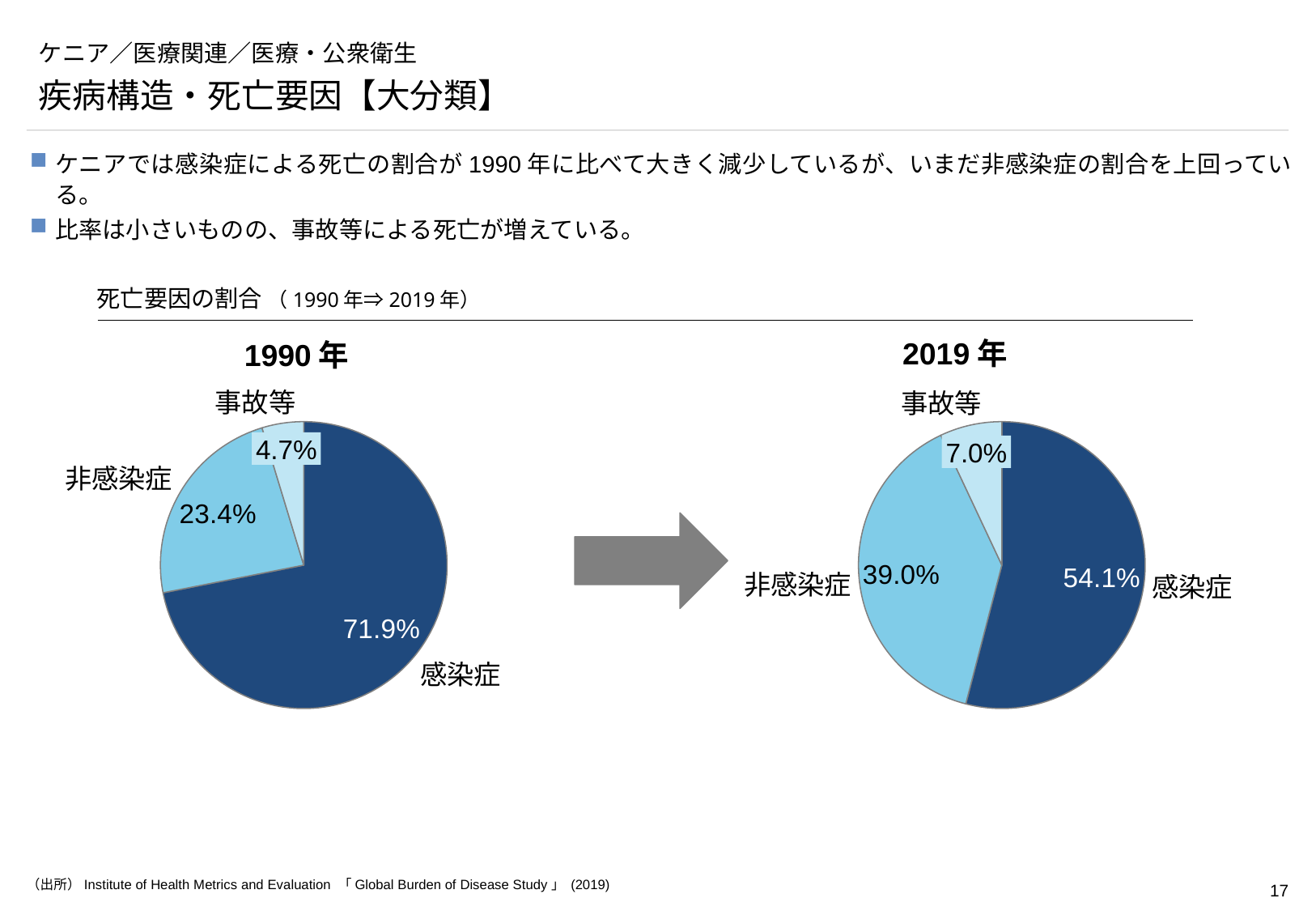
How many categories does the 1990年 pie chart show? 3 In the 1990年 pie chart, what share is 感染症? 71.9% In the 2019年 pie chart, what share is 非感染症? 39.0% In the 2019年 pie chart, what share is 感染症? 54.1% In the 1990年 pie chart, what share is 非感染症? 23.4% Which is larger: the 非感染症 share in 1990年 or the 非感染症 share in 2019年? 2019年 In the 2019年 pie chart, what is the difference between the 感染症 share and the 非感染症 share? 15.1% In the 1990年 pie chart, what share is 事故等? 4.7% In the 2019年 pie chart, which category has the largest share? 感染症 In the 2019年 pie chart, what share is 事故等? 7.0% In the 1990年 pie chart, which category has the smallest share? 事故等 What kind of chart is used to show 死亡要因の割合 on this slide? Pie chart